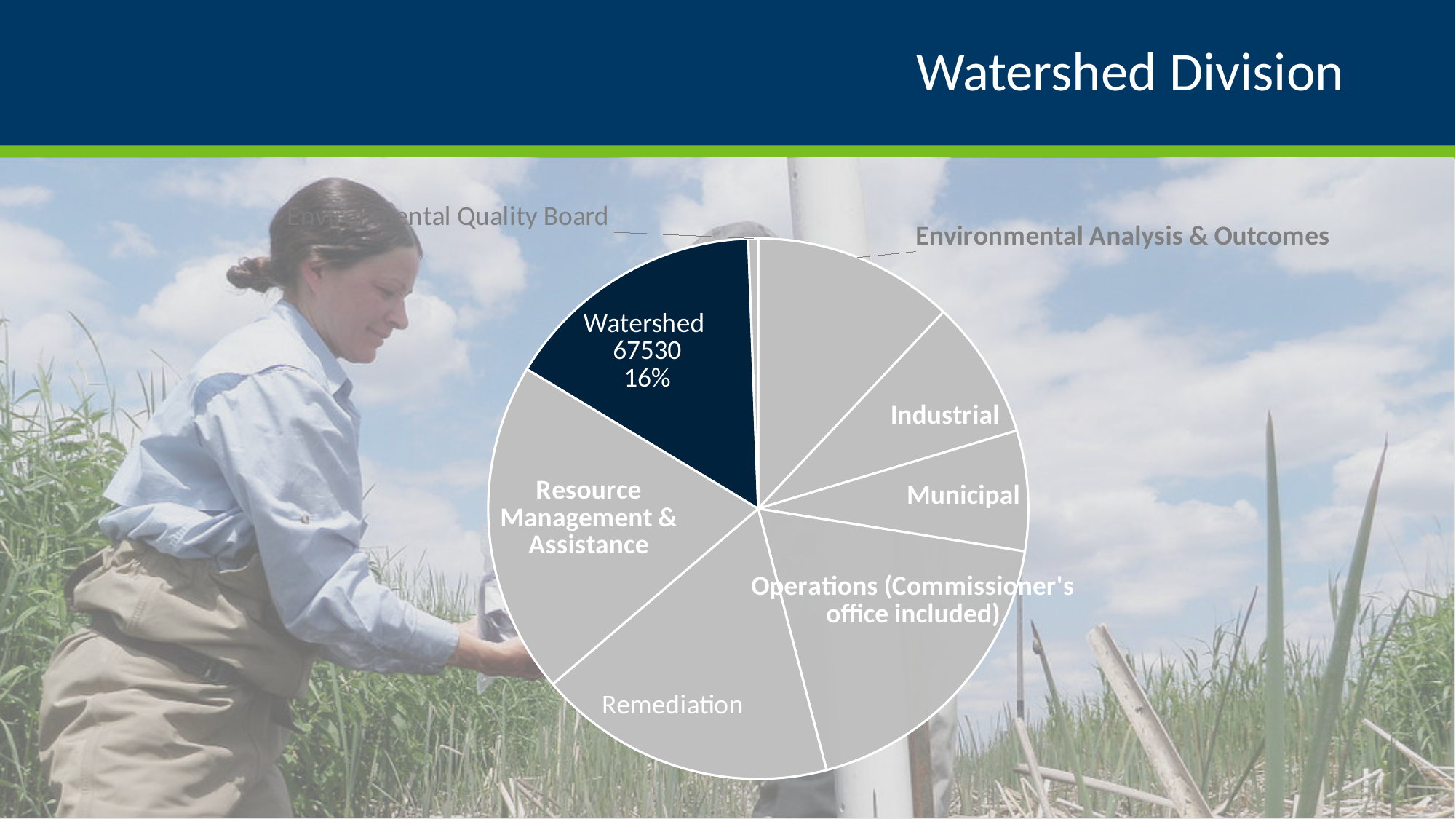
Which slice of the pie chart is the smallest? Environmental Quality Board Which slice is larger, Watershed or Environmental Quality Board? Watershed Which slice is larger, Remediation or Municipal? Remediation Which slice of the pie chart is highlighted in dark blue? Watershed How many slices does the pie chart have? 8 What type of chart is shown on the slide? pie chart Which slice is larger, Resource Management & Assistance or Industrial? Resource Management & Assistance What value is shown for the Watershed slice? 67530 What share of the pie does the Watershed slice represent? 16% What is the title of the slide? Watershed Division